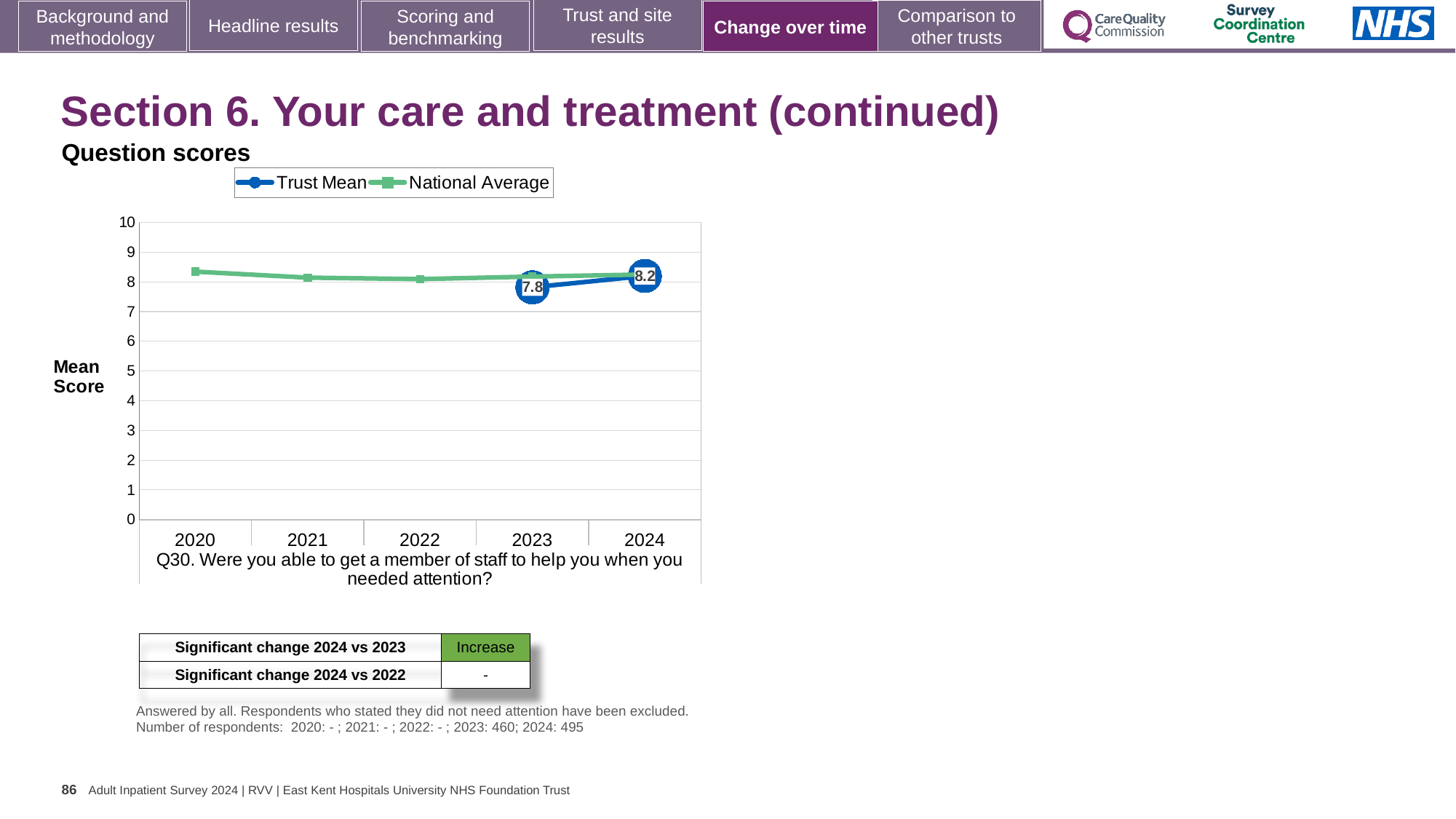
Is the National Average value for 2020 greater or less than 8? greater Which year has the higher Trust Mean score, 2023 or 2024? 2024 What kind of chart is shown on the slide? line chart What is the Trust Mean score for 2024? 8.2 Is the National Average value for 2022 greater or less than 9? less How many years are shown on the x axis of the chart? 5 By how much did the Trust Mean score change from 2023 to 2024? 0.4 Does the Trust Mean line rise or fall from 2023 to 2024? rise Which question does the chart relate to? Q30. Were you able to get a member of staff to help you when you needed attention? How many series does the chart legend list? 2 What is the Trust Mean score for 2023? 7.8 What is the label of the y axis of the chart? Mean Score